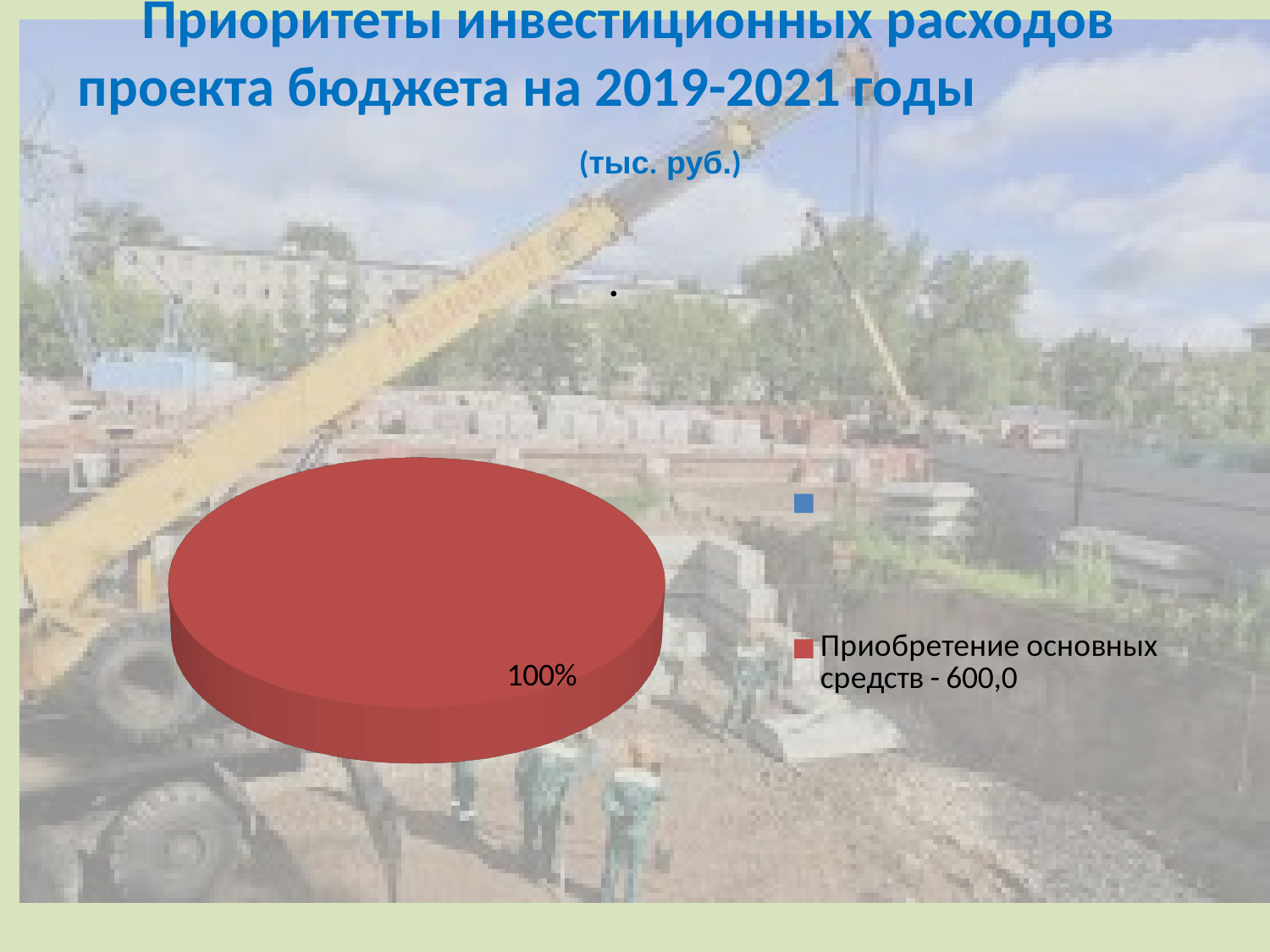
What value is given in the legend for "Приобретение основных средств"? 600,0 How many slices are visible in the pie chart? 1 What colour is the slice for "Приобретение основных средств"? red What share of the pie does the slice labelled "Приобретение основных средств" take? 100% What percentage label is printed next to the pie slice? 100% What unit is stated under the chart title? тыс. руб. What kind of chart is shown on the slide? pie chart